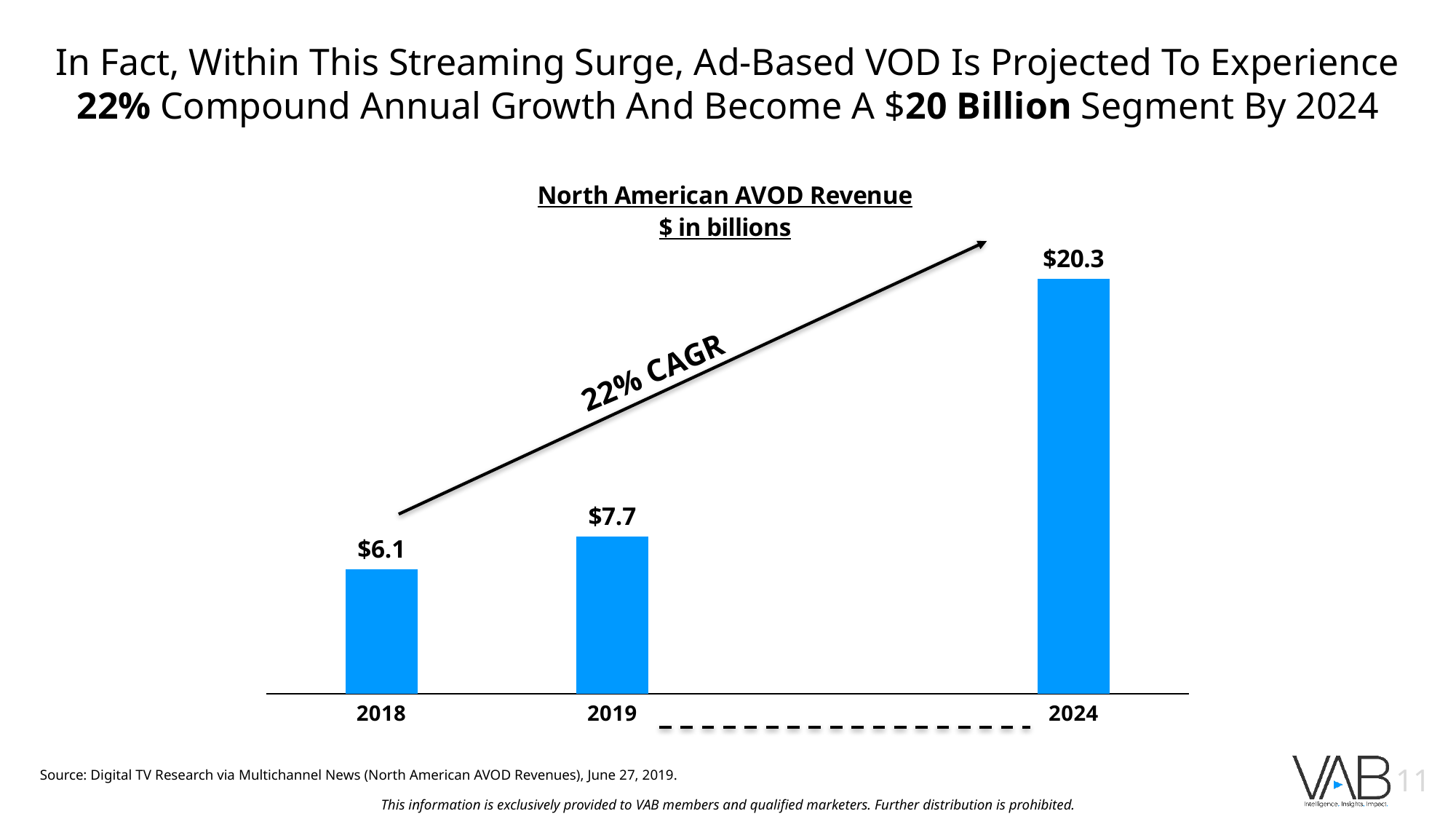
What is the North American AVOD revenue shown for 2018? $6.1 What kind of chart is used to show North American AVOD Revenue? Bar chart What is the difference between the 2019 and 2018 North American AVOD revenue values? $1.6 How many years are plotted on the North American AVOD Revenue chart? 3 Which year has the larger AVOD revenue, 2018 or 2019? 2019 What is the North American AVOD revenue shown for 2024? $20.3 What is the difference between the 2024 and 2018 North American AVOD revenue values? $14.2 Do the North American AVOD revenue values rise or fall from 2018 to 2024? Rise Which year has the highest North American AVOD revenue on the chart? 2024 What is the North American AVOD revenue shown for 2019? $7.7 What CAGR is labelled on the arrow above the bars? 22% CAGR Which year has the lowest North American AVOD revenue on the chart? 2018